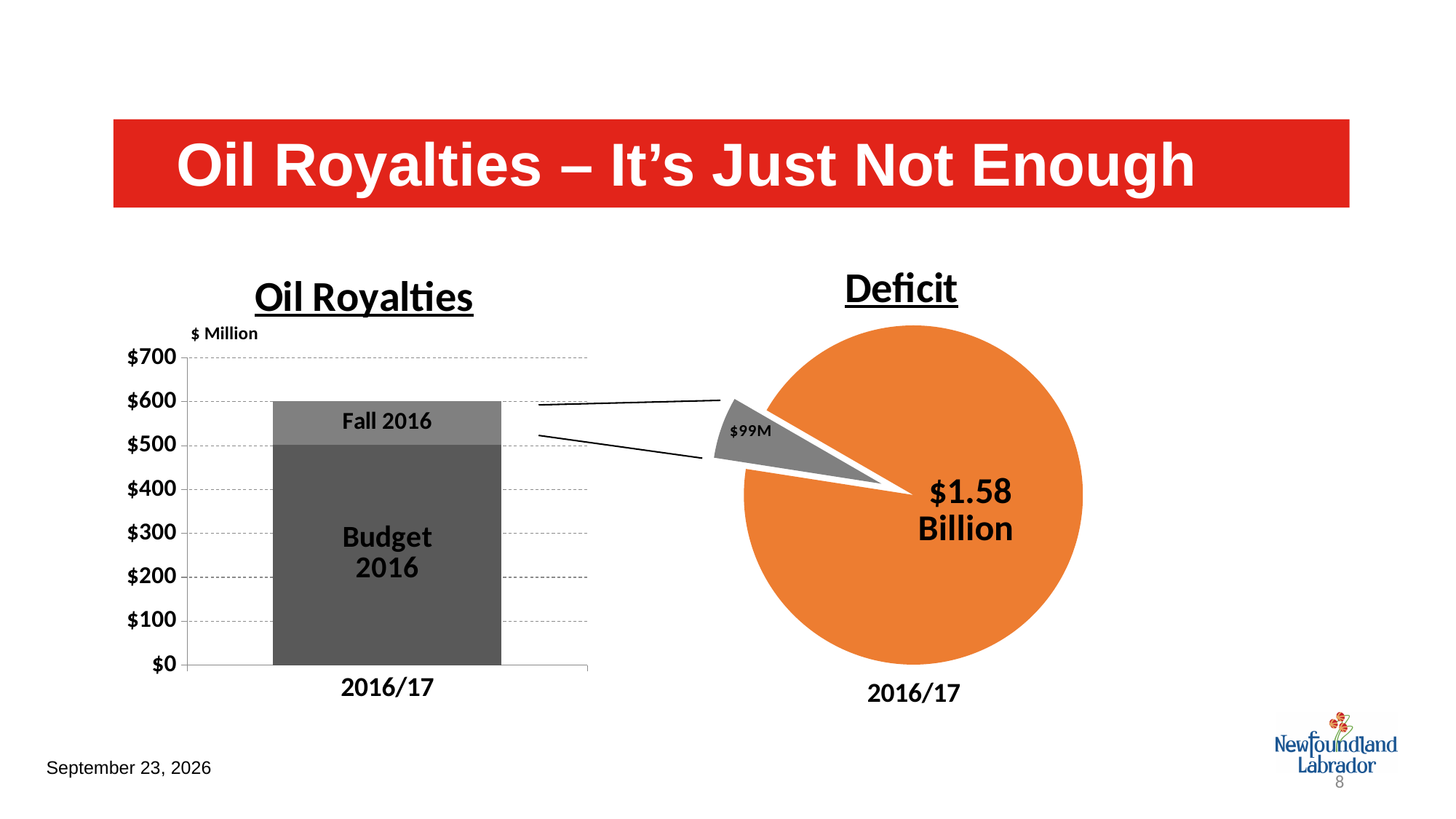
In the Deficit chart, what value is labelled on the small grey slice? $99M What kind of chart is the Oil Royalties chart on the left? bar chart In the Oil Royalties chart, which segment is larger, Budget 2016 or Fall 2016? Budget 2016 In the Deficit chart, what value is labelled on the large orange slice? $1.58 Billion In the Oil Royalties chart, what value does the Budget 2016 segment reach? $500 In the Oil Royalties chart, how many categories are shown on the x axis? 1 In the Oil Royalties chart, what is the total height of the 2016/17 bar? $600 What kind of chart is the Deficit chart on the right? pie chart In the Oil Royalties chart, what unit is shown above the y axis? $ Million In the Oil Royalties chart, how many segments make up the 2016/17 bar? 2 In the Deficit chart, which period is shown below the pie? 2016/17 In the Oil Royalties chart, is the Budget 2016 segment greater or less than $400? greater